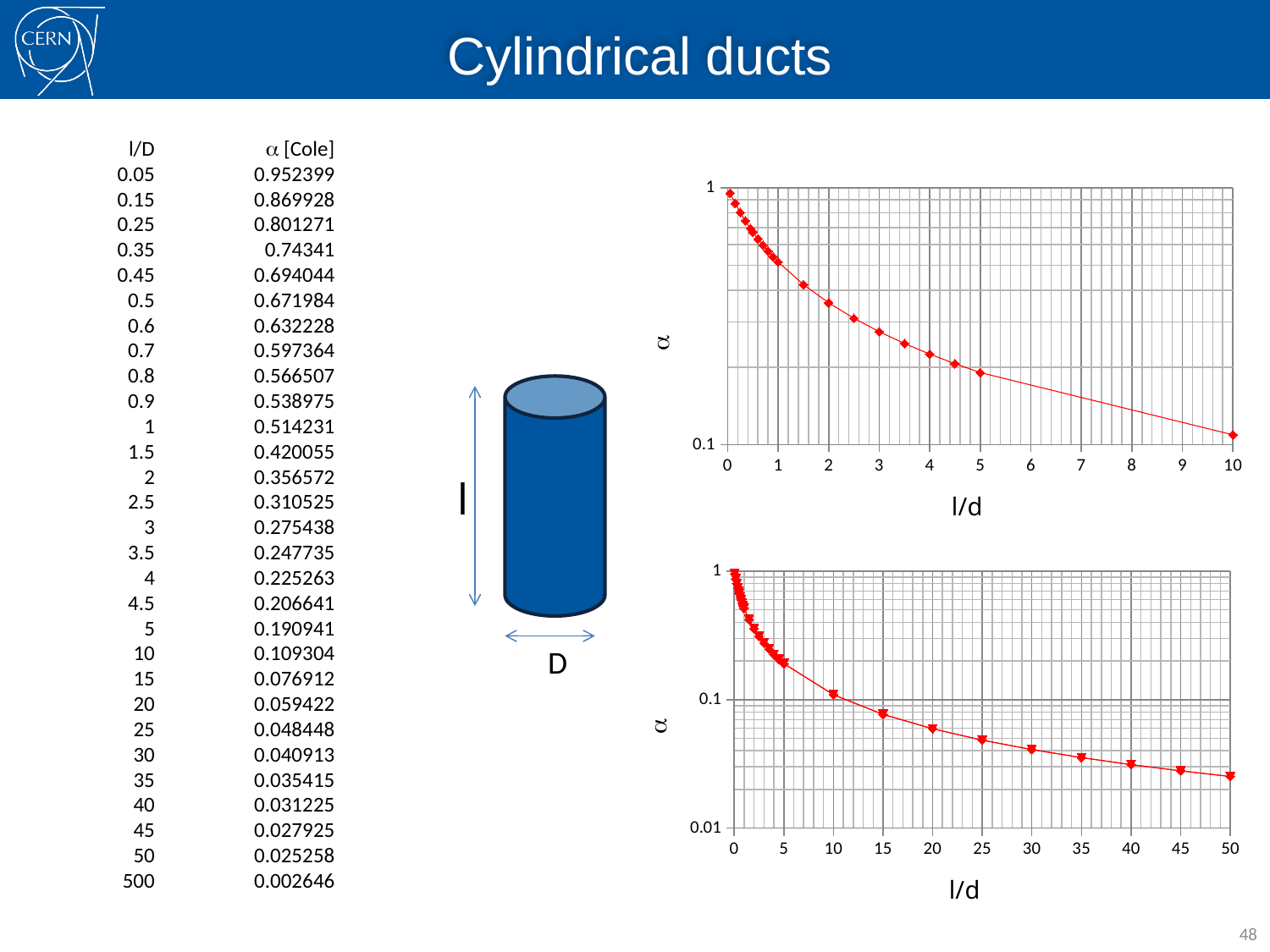
What is the lowest value shown on the y axis of the bottom chart? 0.01 According to the table on the slide, what is α [Cole] for l/D = 500? 0.002646 What is the label on the x axis of the bottom chart? l/d In the top chart, do the values of α rise or fall as l/d increases? fall According to the table on the slide, which l/D value has the highest α [Cole]? 0.05 According to the table on the slide, what is α [Cole] for l/D = 1? 0.514231 What is the highest l/d value shown on the x axis of the top chart? 10 What kind of chart is the top chart on the slide? line chart In the bottom chart, is the value of α at l/d = 50 greater or less than 0.01? greater In the top chart, is the value of α at l/d = 5 greater or less than 0.1? greater In the top chart, which has the larger α value: l/d = 1 or l/d = 5? l/d = 1 In the bottom chart, is the value of α at l/d = 50 greater or less than 0.1? less